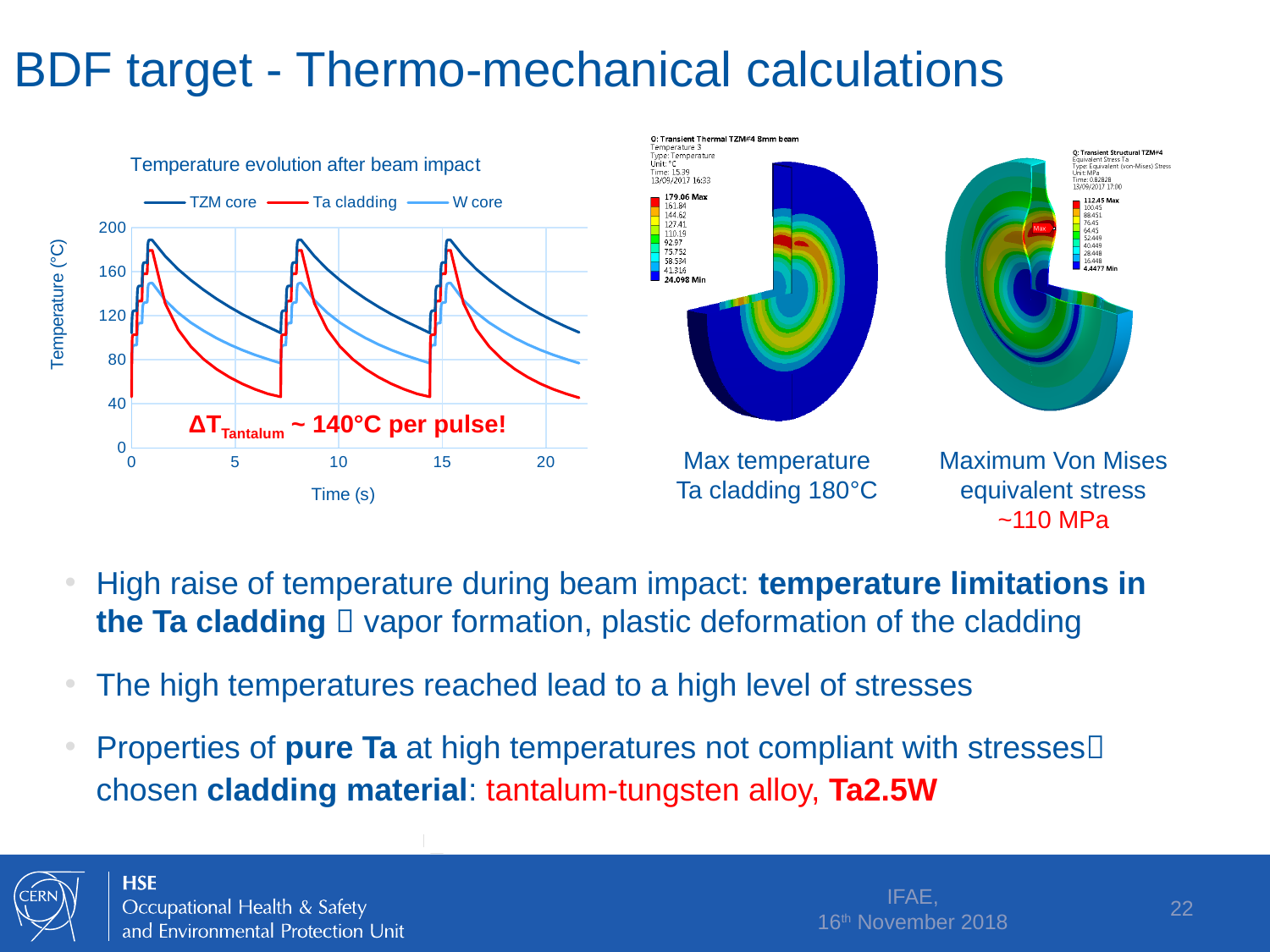
Between pulses, does the Ta cladding temperature rise or fall over time? fall What is the title of the chart on the slide? Temperature evolution after beam impact Is the peak temperature of the TZM core greater or less than 160? greater What is the maximum value shown on the Temperature (°C) axis of the chart? 200 Which series reaches the lowest peak temperature in the chart? W core Is the minimum temperature of the Ta cladding between pulses greater or less than 80? less How many temperature peaks (beam pulses) are shown in the chart? 3 What kind of chart is shown on the slide? line chart How many series does the legend of the temperature chart list? 3 Which series drops to the lowest temperature between pulses? Ta cladding Is the peak temperature of the W core greater or less than 120? greater Which series are listed in the legend of the temperature chart? TZM core, Ta cladding, W core